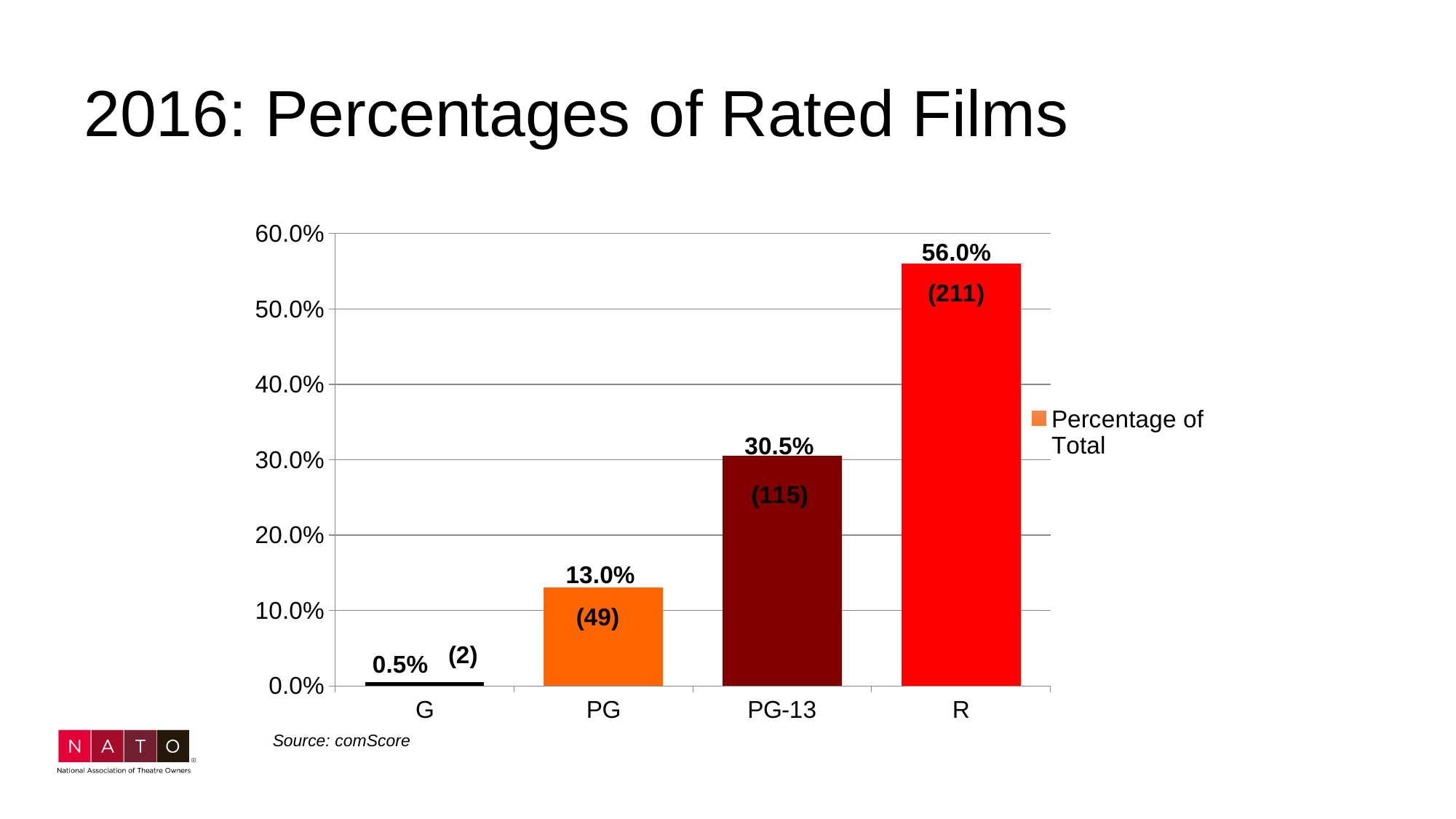
What is the percentage of total for R-rated films? 56.0% What is the difference in percentage points between R and PG-13? 25.5% Which rating has the highest percentage of total? R How many series does the legend list? 1 Which has a larger percentage of total, PG or PG-13? PG-13 How many films are shown in parentheses for the G rating? 2 What is the percentage of total for PG-13 films? 30.5% Which rating has the lowest percentage of total? G What kind of chart is shown on the slide? Bar chart What is the percentage of total for PG films? 13.0% Do the values rise or fall moving from G to R along the x axis? Rise How many rating categories are shown on the x axis? 4